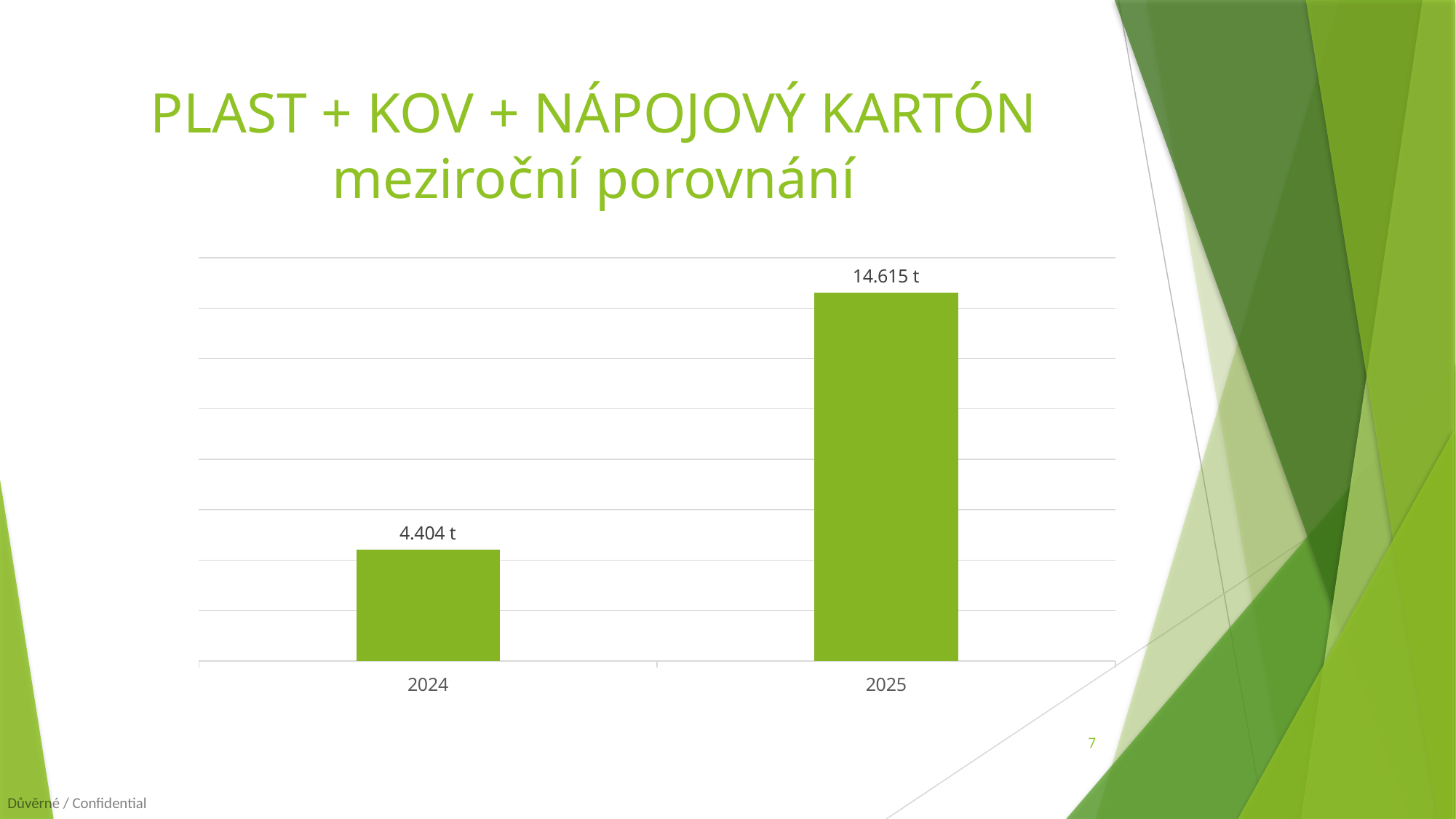
Which year has the lowest value? 2024 Which is larger, the value for 2024 or the value for 2025? 2025 What is the difference between the values for 2025 and 2024? 10.211 t What is the value for 2025? 14.615 t What colour are the bars in the chart? green What kind of chart is shown on the slide? bar chart Do the values rise or fall from 2024 to 2025? rise What is the title of the slide containing the chart? PLAST + KOV + NÁPOJOVÝ KARTÓN meziroční porovnání Which year has the highest value? 2025 How many categories are shown on the x axis? 2 What is the value for 2024? 4.404 t